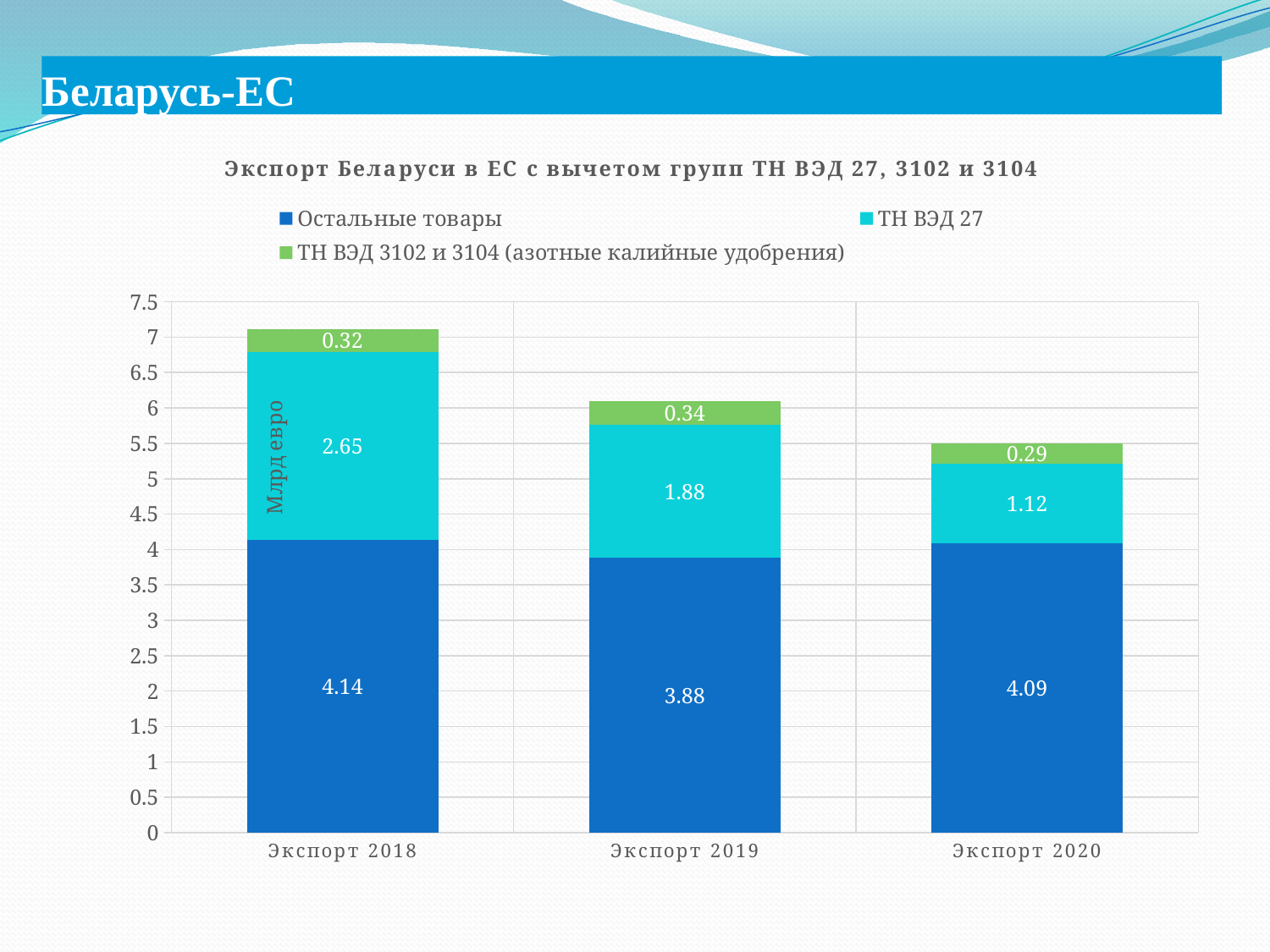
What is the value for Остальные товары in Экспорт 2019? 3.88 What is the difference between the ТН ВЭД 27 values for Экспорт 2018 and Экспорт 2019? 0.77 What is the value for ТН ВЭД 27 in Экспорт 2020? 1.12 How many series does the legend list? 3 In which year is the value for ТН ВЭД 27 the highest? Экспорт 2018 Which is larger: the Остальные товары value for Экспорт 2018 or for Экспорт 2020? Экспорт 2018 What is the total of the stacked bar for Экспорт 2019? 6.1 In which year is the value for Остальные товары the lowest? Экспорт 2019 Do the values for ТН ВЭД 27 rise or fall from Экспорт 2018 to Экспорт 2020? Fall What is the value for ТН ВЭД 3102 и 3104 (азотные калийные удобрения) in Экспорт 2018? 0.32 What is the total of the stacked bar for Экспорт 2020? 5.5 What kind of chart is shown on the slide? Stacked bar chart